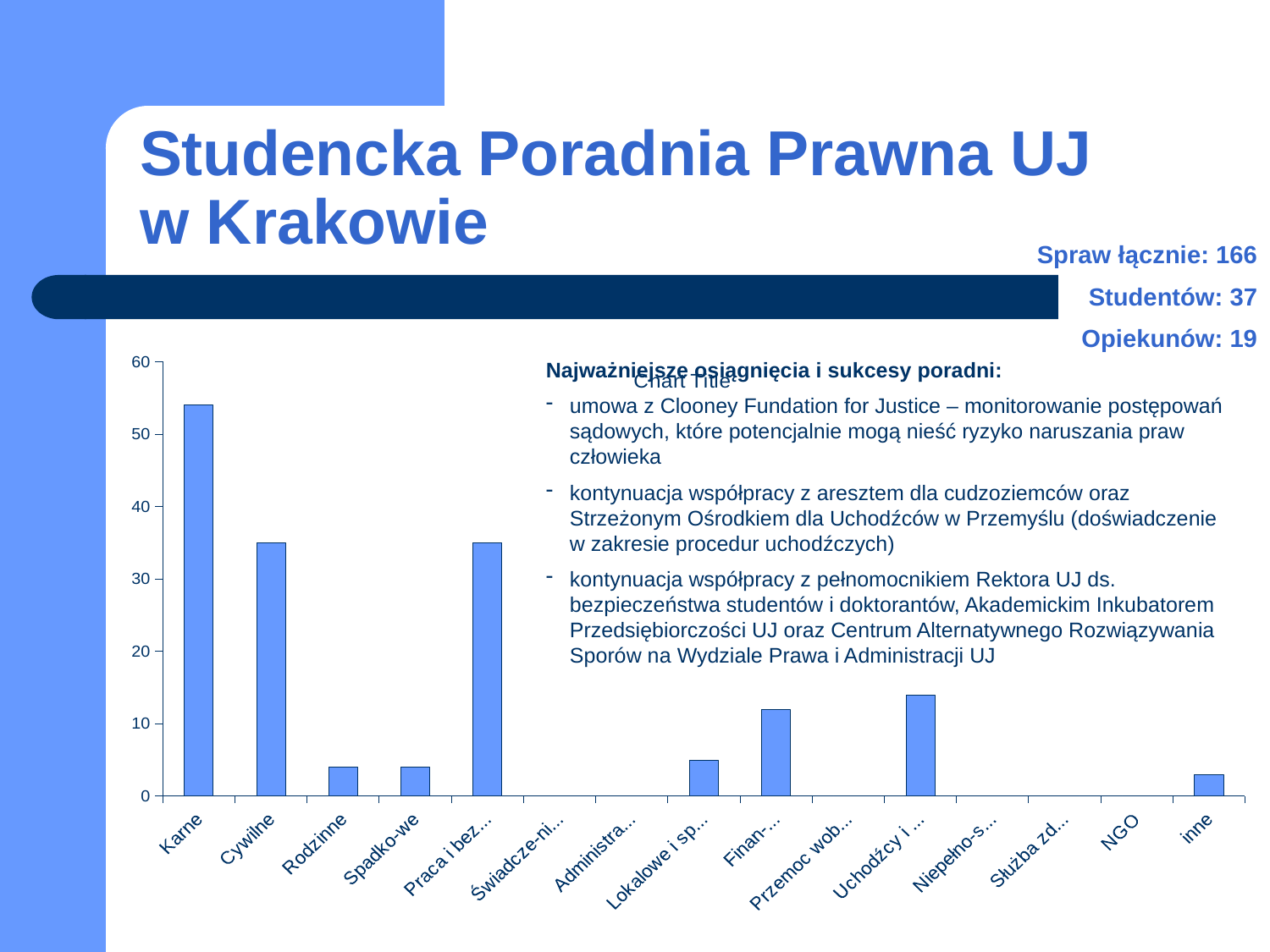
Which is larger, the value for Karne or the value for Cywilne? Karne What kind of chart is shown on the slide? bar chart What is the title shown on the chart? Chart Title Is the value for Rodzinne greater or less than 10? less Is the value for Cywilne greater or less than 40? less Which is larger, the value for Rodzinne or the value for Finan-...? Finan-... Is the value for inne greater or less than 10? less Which category has the highest value in the chart? Karne How many categories are shown on the x axis of the chart? 15